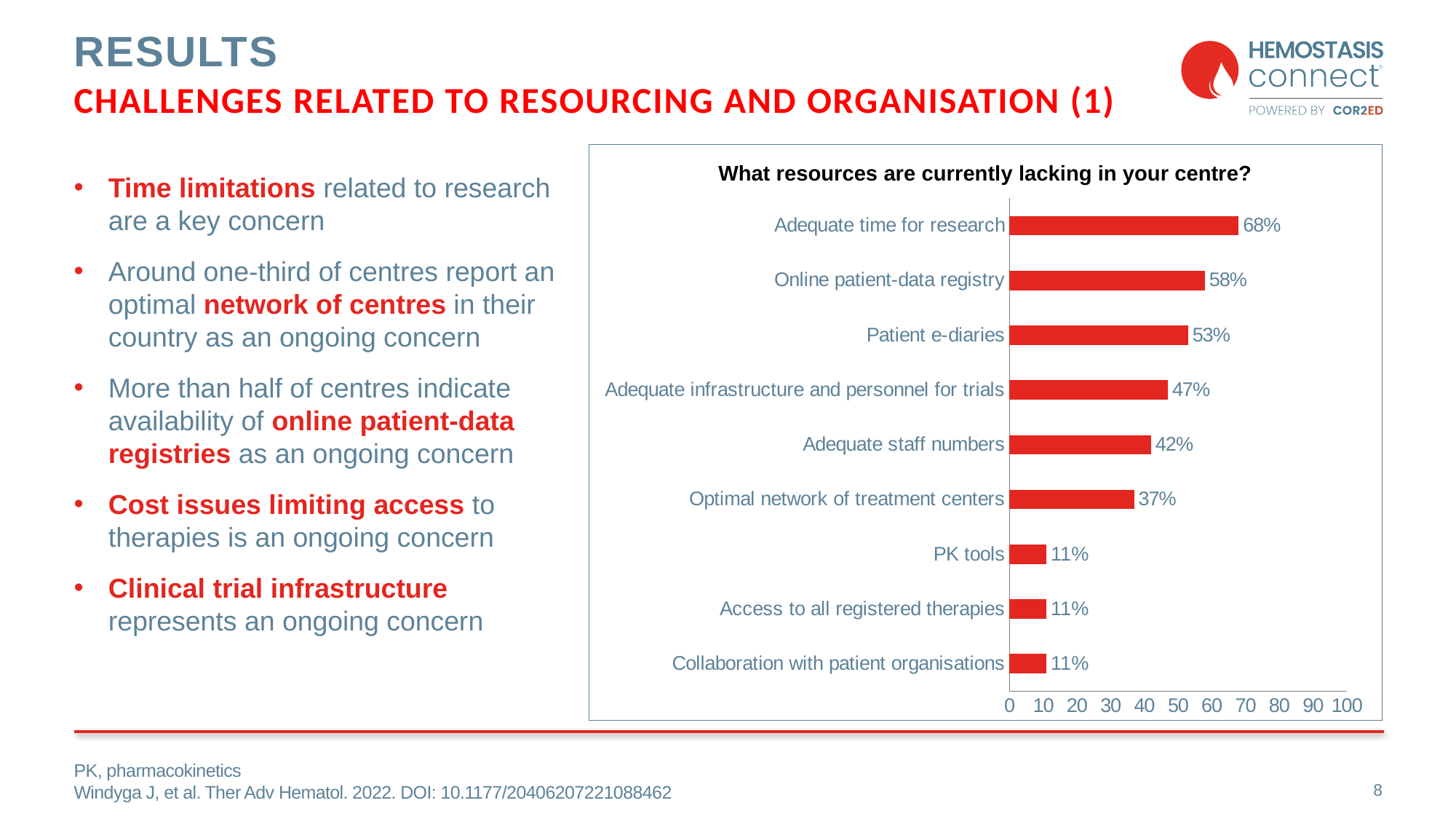
Which is larger, the value for Patient e-diaries or the value for Adequate staff numbers? Patient e-diaries Is the value for Optimal network of treatment centers greater or less than 40? less What kind of chart is shown on the slide? Bar chart What is the title of the chart? What resources are currently lacking in your centre? What percentage of centres report lacking adequate time for research? 68% Which resource has the highest percentage of centres reporting it as lacking? Adequate time for research What is the value for Adequate staff numbers? 42% How many categories share the lowest value of 11%? 3 What is the difference between the values for Adequate infrastructure and personnel for trials and Optimal network of treatment centers? 10% What is the difference between the values for Adequate time for research and Online patient-data registry? 10% How many categories are shown in the chart? 9 What is the value for Patient e-diaries? 53%